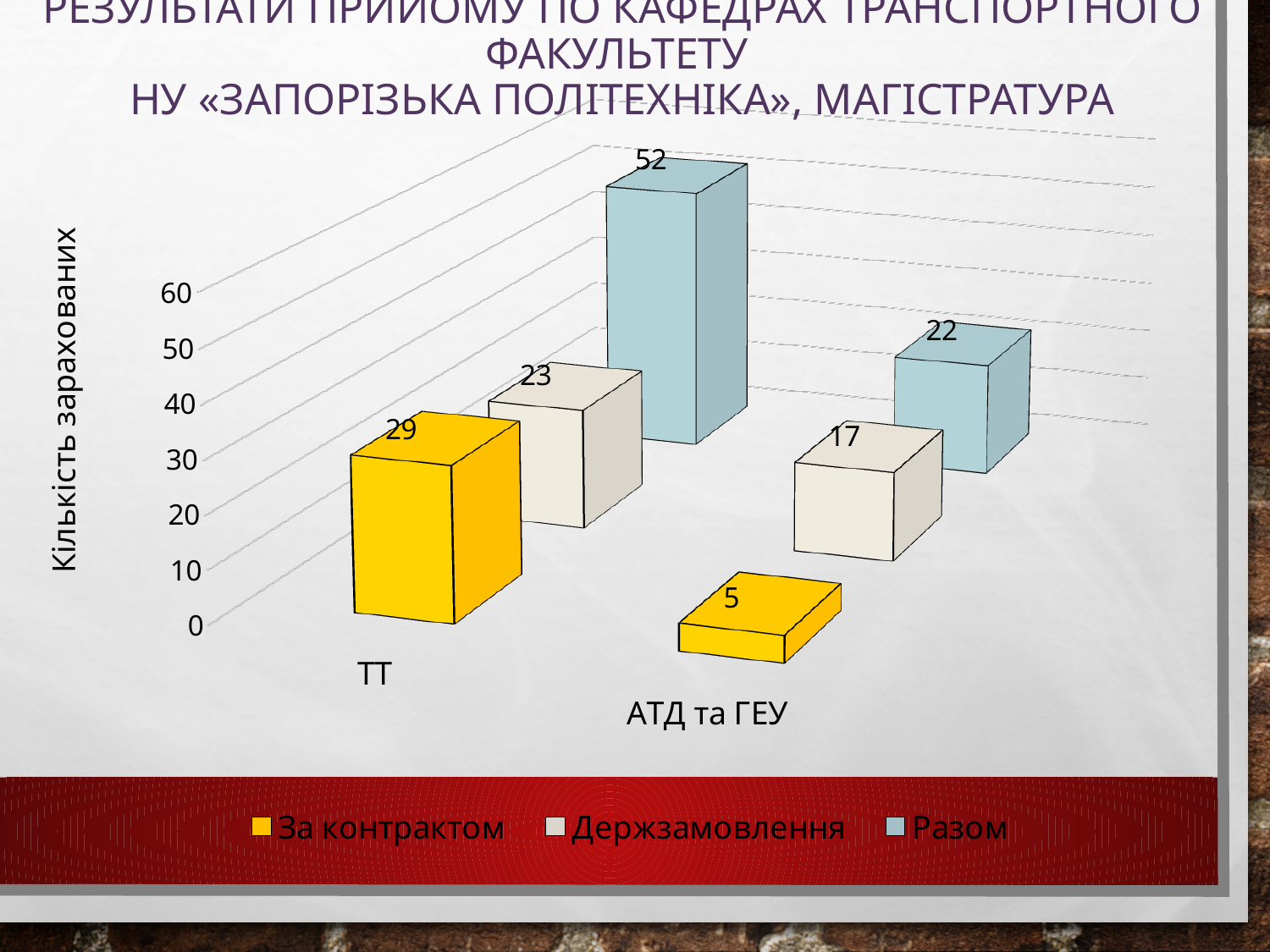
What is the value for Разом for ТТ? 52 What kind of chart is shown on the slide? Bar chart Which category has the highest value for Разом? ТТ What is the label of the vertical axis? Кількість зарахованих What is the value for За контрактом for ТТ? 29 What is the difference between the Разом values for ТТ and АТД та ГЕУ? 30 Which category has the lowest value for За контрактом? АТД та ГЕУ How many series does the legend list? 3 Which is larger for ТТ: За контрактом or Держзамовлення? За контрактом How many categories are shown on the x axis? 2 What is the value for Держзамовлення for АТД та ГЕУ? 17 What is the value for За контрактом for АТД та ГЕУ? 5